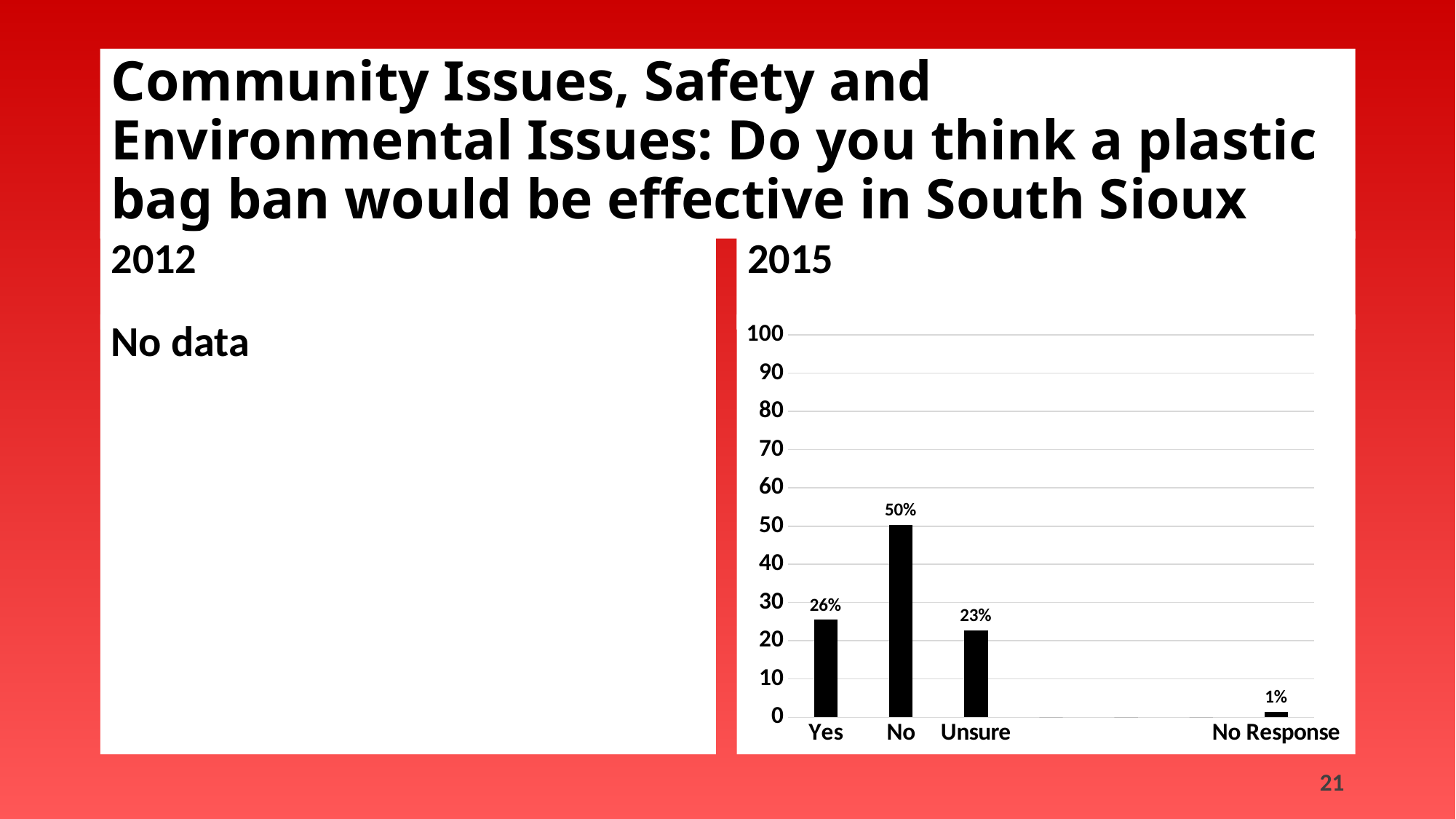
In the 2015 chart, what percentage of respondents answered "No"? 50% In the 2015 chart, which is larger, the value for "Yes" or the value for "Unsure"? Yes In the 2015 chart, what is the value for "No Response"? 1% What kind of chart is used for the 2015 data? Bar chart In the 2015 chart, what is the difference between the "No" and "Yes" values? 24% In the 2015 chart, what is the difference between the "Yes" and "Unsure" values? 3% How many response categories are shown in the 2015 chart? 4 In the 2015 chart, what is the value for "Unsure"? 23% In the 2015 chart, is the value for "No" greater or less than 40? greater In the 2015 chart, which response category has the lowest value? No Response In the 2015 chart, which response category has the highest value? No In the 2015 chart, what percentage of respondents answered "Yes"? 26%